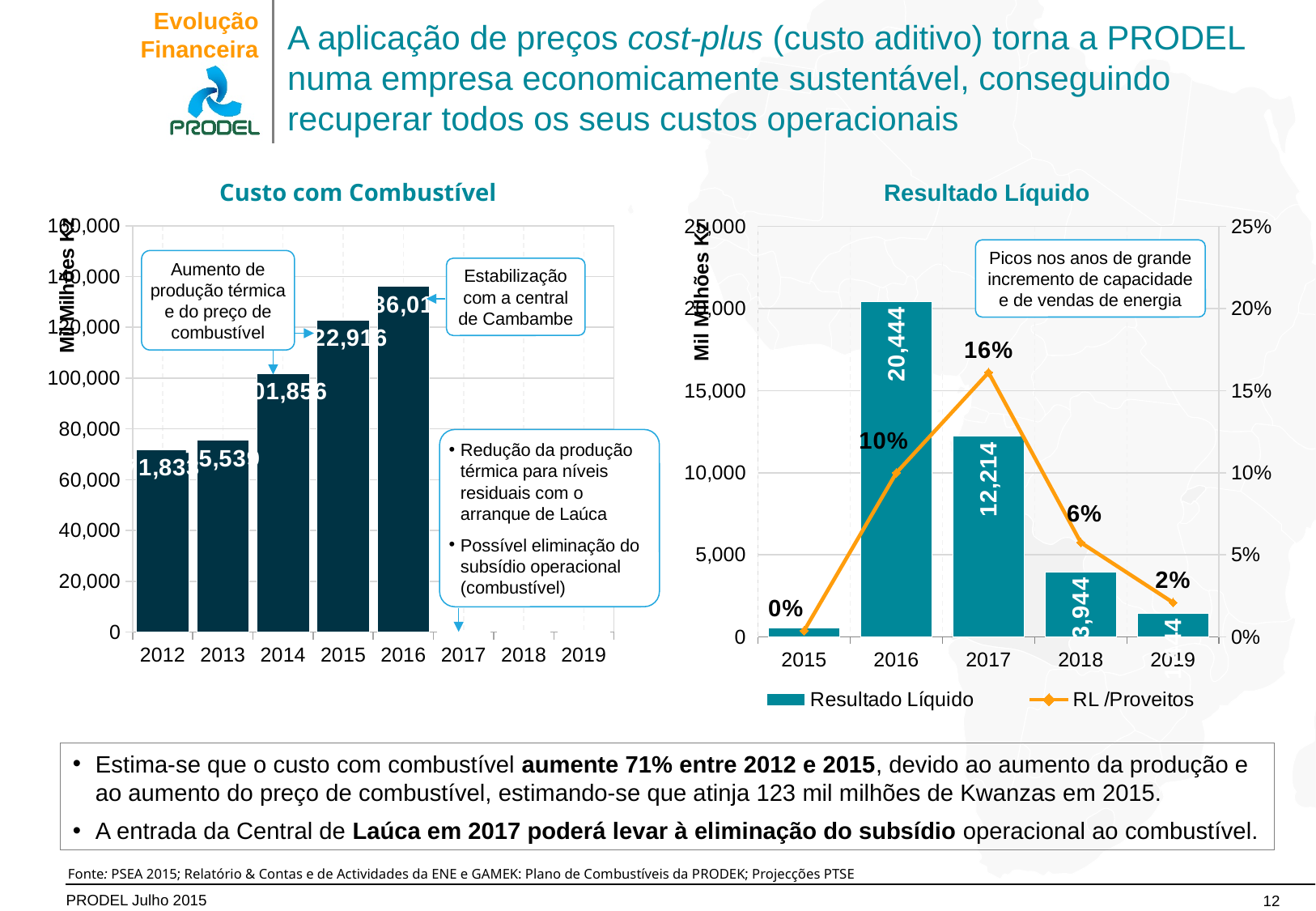
In the 'Custo com Combustível' chart, is the value for 2014 greater or less than 100,000? greater How many years are shown on the x axis of the 'Resultado Líquido' chart? 5 How many series does the legend of the 'Resultado Líquido' chart list? 2 In the 'Resultado Líquido' chart, what is the RL /Proveitos value for 2017? 16% In the 'Resultado Líquido' chart, what is the difference between the Resultado Líquido values for 2016 and 2017? 8,230 In the 'Custo com Combustível' chart, which year has the highest bar? 2016 In the 'Resultado Líquido' chart, what is the Resultado Líquido value for 2016? 20,444 In the 'Resultado Líquido' chart, which year has the highest RL /Proveitos value? 2017 In the 'Custo com Combustível' chart, do the bars rise or fall from 2012 to 2016? rise In the 'Custo com Combustível' chart, what is the value for 2015? 122,916 What kind of chart is the 'Custo com Combustível' chart? bar chart In the 'Resultado Líquido' chart, what is the Resultado Líquido value for 2018? 3,944